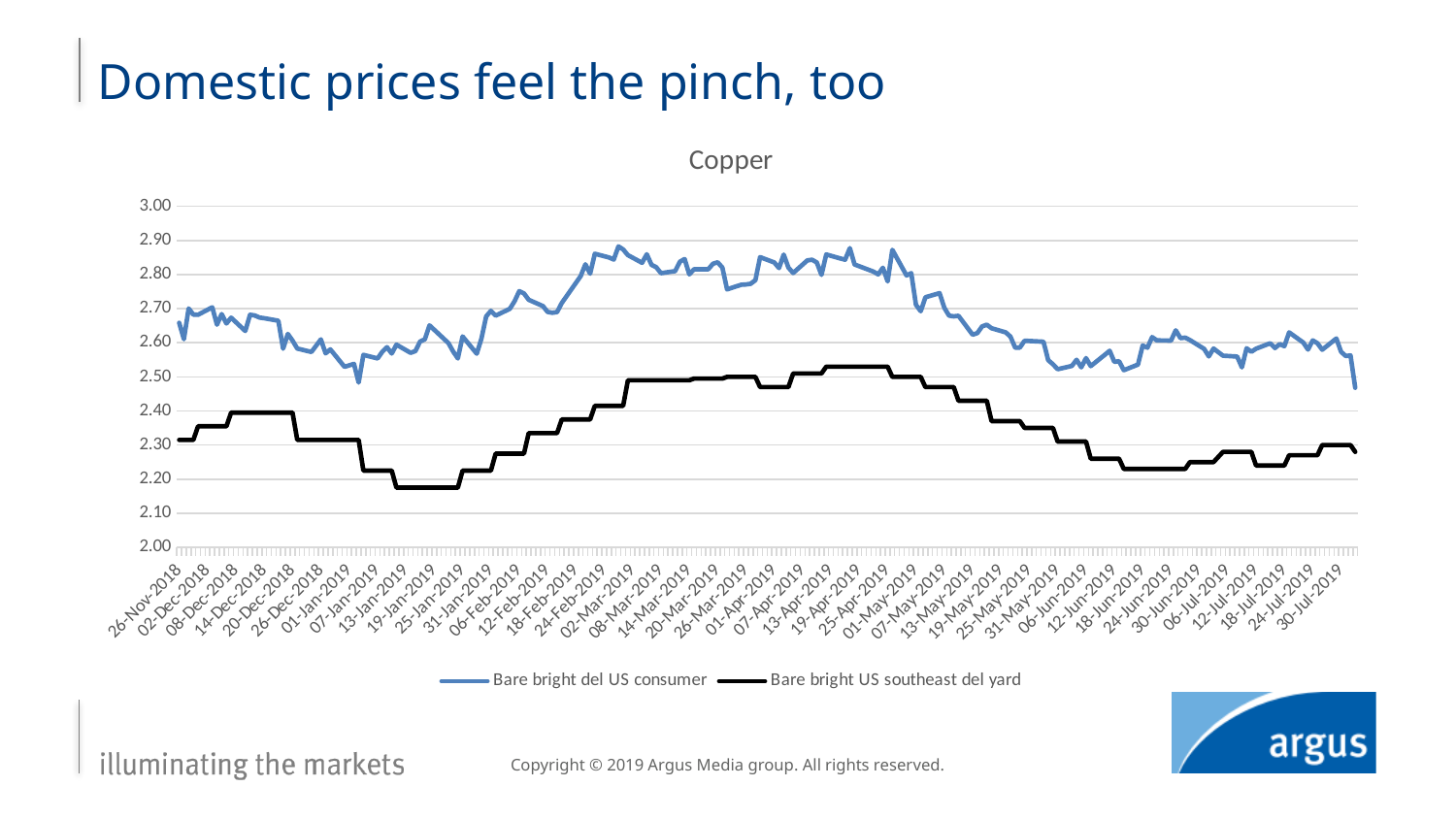
What kind of chart is shown on the slide? line chart Does the Bare bright del US consumer series rise or fall between 25-Apr-2019 and 31-May-2019? fall Which series reaches the highest value on the chart? Bare bright del US consumer Is the value for Bare bright US southeast del yard on 19-Jan-2019 greater or less than 2.30? less Is the value for Bare bright US southeast del yard on 19-Apr-2019 greater or less than 2.40? greater Does the Bare bright US southeast del yard series rise or fall between 19-Jan-2019 and 19-Apr-2019? rise Which series is drawn in black? Bare bright US southeast del yard What is the title of the chart? Copper How many series does the legend list? 2 Is the value for Bare bright del US consumer on 26-Nov-2018 greater or less than 2.50? greater Which series has the higher value on 01-Apr-2019? Bare bright del US consumer